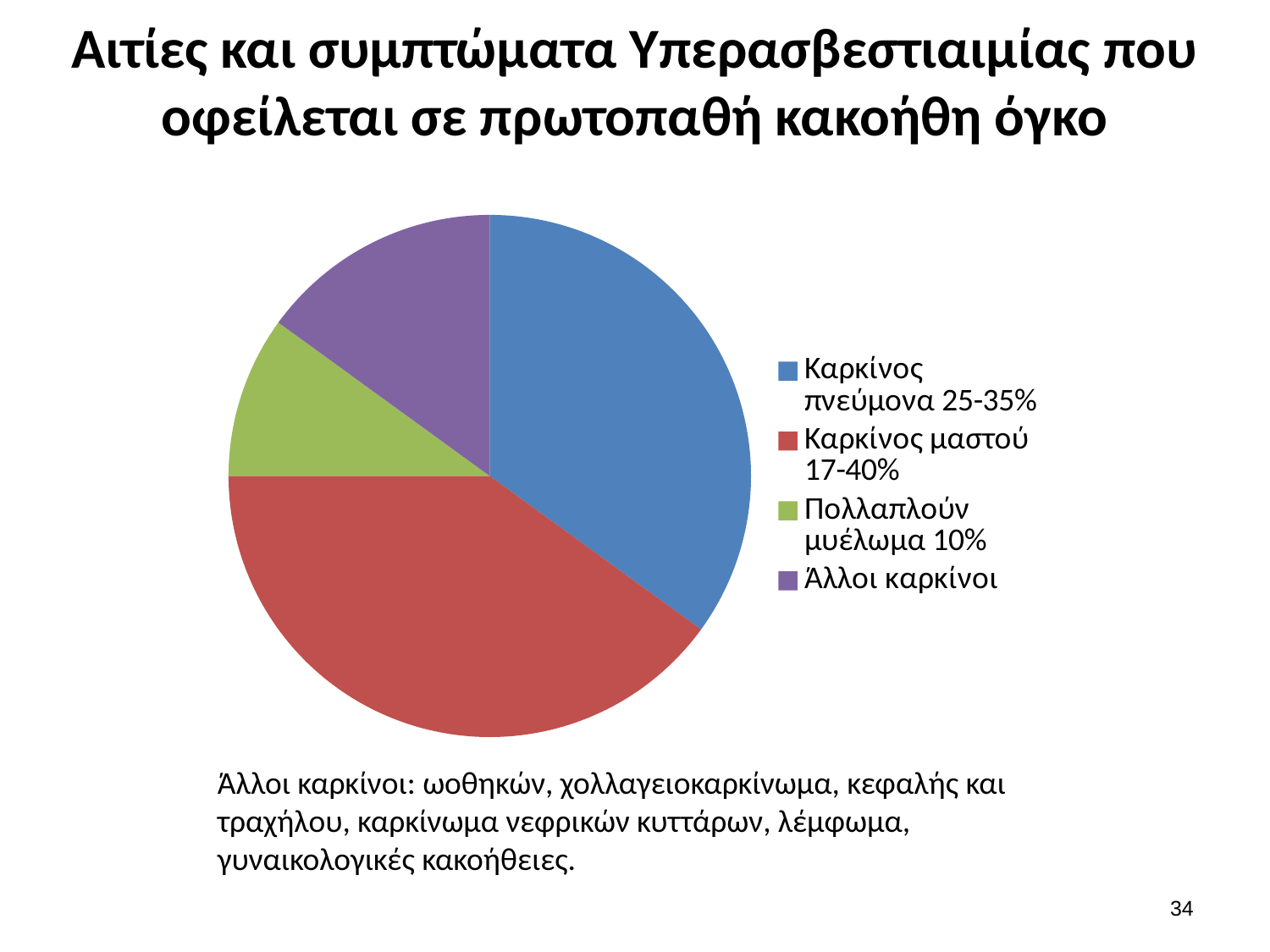
What colour is the slice for Άλλοι καρκίνοι in the pie chart? purple Which slice is larger: Καρκίνος πνεύμονα or Άλλοι καρκίνοι? Καρκίνος πνεύμονα Which slice is larger: Άλλοι καρκίνοι or Πολλαπλούν μυέλωμα? Άλλοι καρκίνοι Which category has the smallest slice of the pie chart? Πολλαπλούν μυέλωμα 10% What kind of chart is shown on the slide? pie chart Which slice is larger: Καρκίνος μαστού or Πολλαπλούν μυέλωμα? Καρκίνος μαστού What share of the pie does the legend give for Πολλαπλούν μυέλωμα? 10% How many entries does the legend of the pie chart list? 4 What colour is the slice for Καρκίνος μαστού in the pie chart? red Which category has the largest slice of the pie chart? Καρκίνος μαστού 17-40% How many slices does the pie chart have? 4